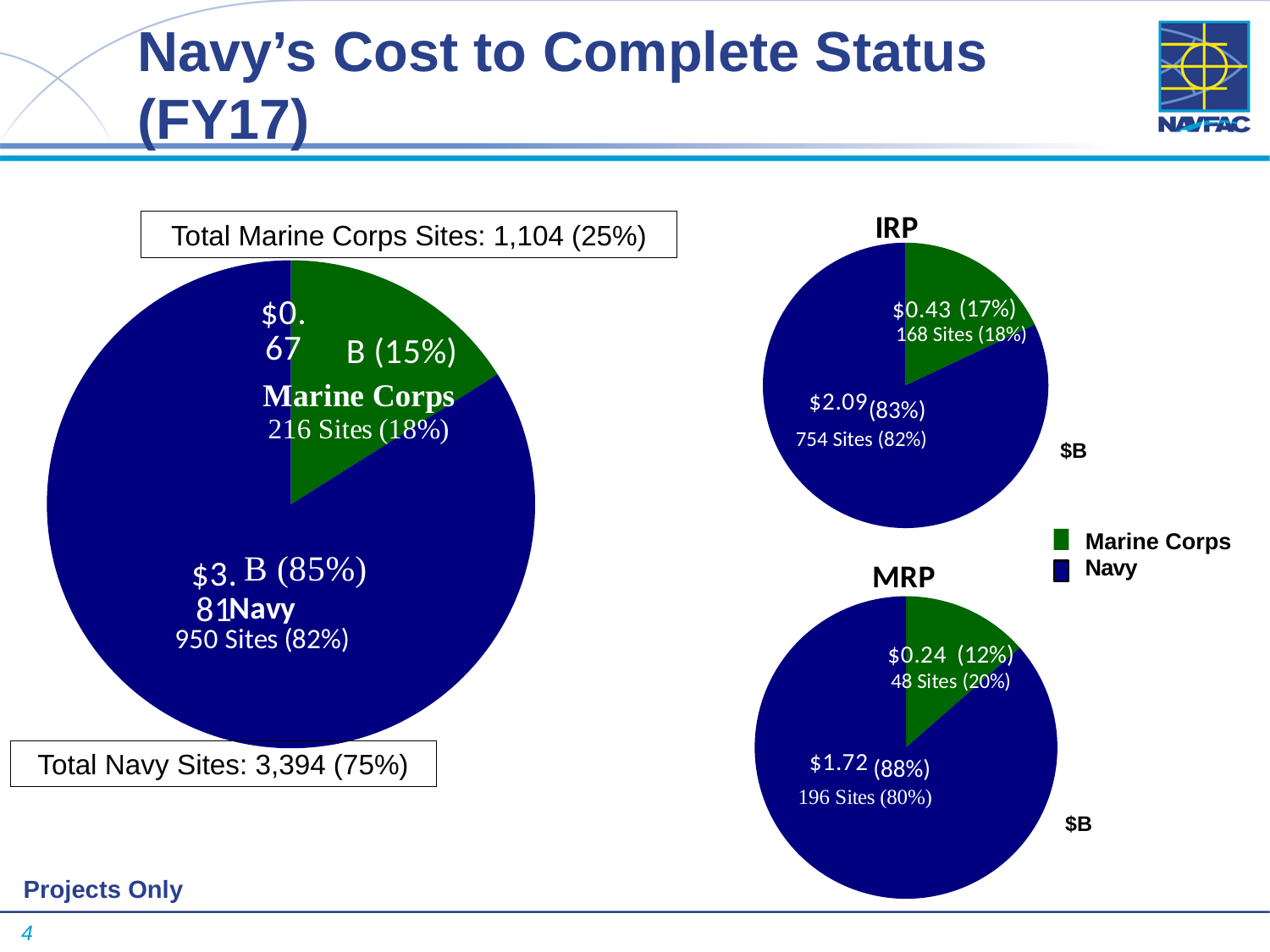
How many entries does the legend list? 2 In the large pie chart on the left, which slice is larger, Navy or Marine Corps? Navy In the IRP pie chart, what share of the pie is Navy? 83% Which colour represents Marine Corps in the legend? Green In the MRP pie chart, how many sites are listed for Marine Corps? 48 Sites (20%) In the IRP pie chart, how many sites are listed for Navy? 754 Sites (82%) In the large pie chart on the left, what share of the pie is Navy? 85% In the MRP pie chart, what is the value for Navy? $1.72 In the IRP pie chart, what is the value for Marine Corps? $0.43 What kind of charts are shown on the slide? Pie charts In the MRP pie chart, what share of the pie is Marine Corps? 12% How many pie charts are on the slide? 3